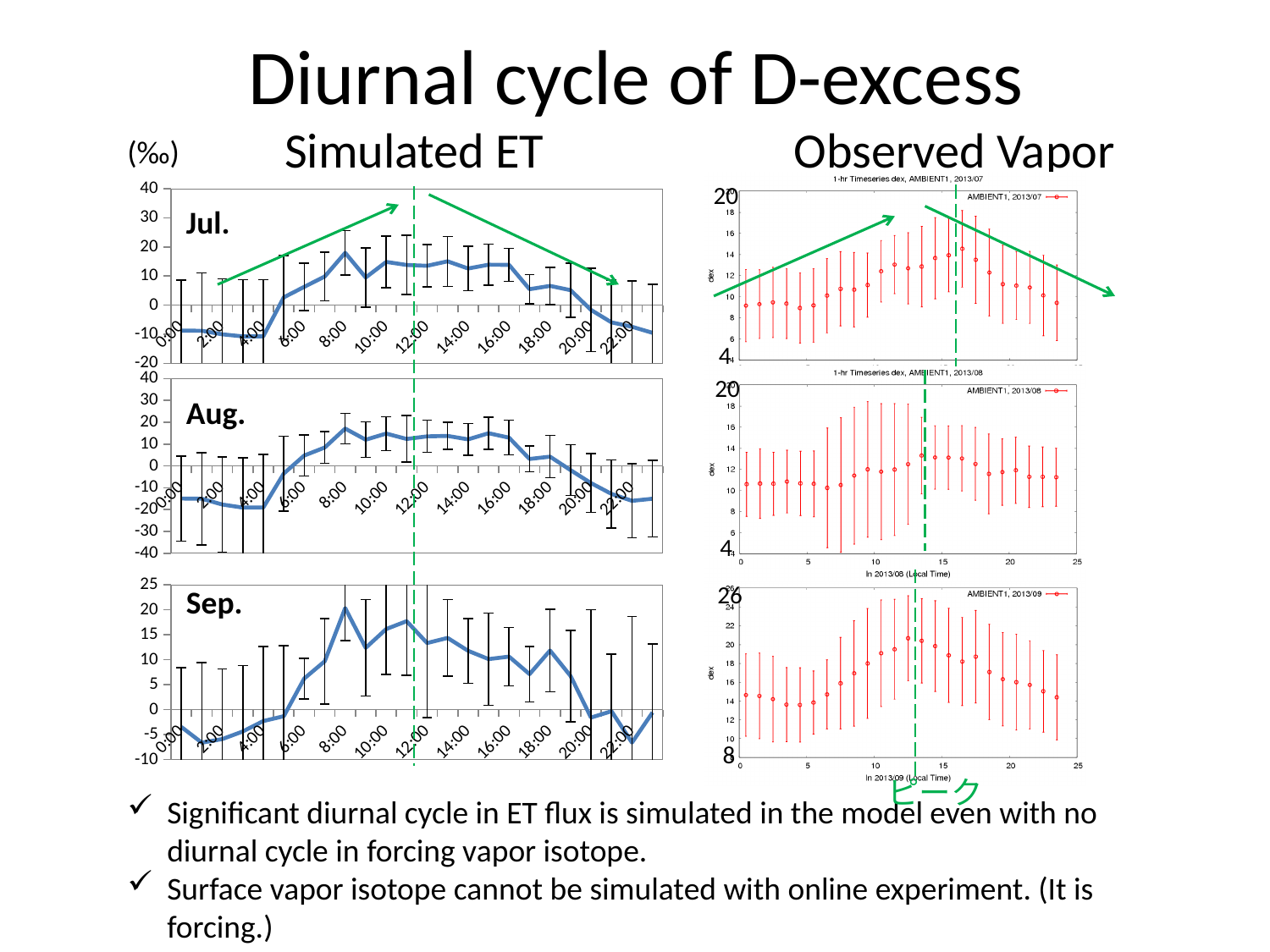
What legend entry is shown in the Observed Vapor chart for July (top right)? AMBIENT1, 2013/07 In the Simulated ET Aug. chart, do the values rise or fall from 16:00 to 22:00? fall How many Simulated ET panels (months) are shown on the left side of the slide? 3 In the Simulated ET Aug. chart, is the value at 0:00 greater or less than 0? less What is the highest y-axis value shown on the Observed Vapor chart for September (bottom right)? 26 In the Simulated ET Jul. chart, is the value at 8:00 greater or less than 10? greater In the Simulated ET Jul. chart, which is larger, the value at 8:00 or the value at 22:00? 8:00 What unit is shown for the y axis of the Simulated ET charts? (‰) What kind of chart is the Simulated ET Jul. chart on the left? line chart In the Simulated ET Sep. chart, is the value at 2:00 greater or less than 0? less In the Simulated ET Jul. chart, do the values rise or fall from 0:00 to 8:00? rise